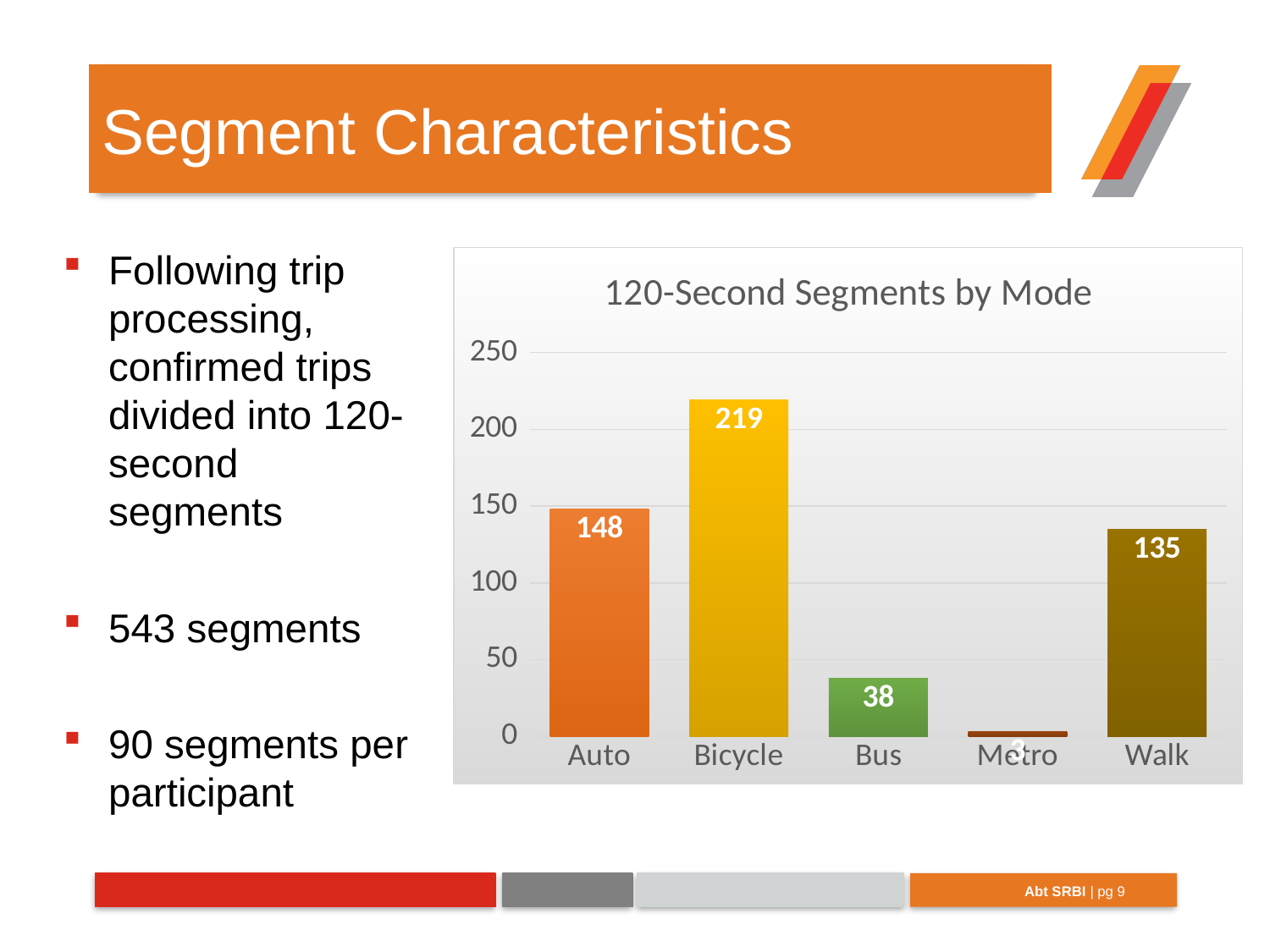
How many modes are shown on the x axis of the chart? 5 What is the value for Bus in the chart? 38 Which has a larger value, Auto or Walk? Auto Which mode has the lowest number of 120-second segments? Metro Which mode has the highest number of 120-second segments? Bicycle How many 120-second segments are shown for Bicycle? 219 What type of chart is shown on the slide? bar chart What is the value for Walk in the chart? 135 Is the value for Bus greater or less than 50? less What is the value for Auto in the chart? 148 What is the title of the chart? 120-Second Segments by Mode What is the difference between the values for Bicycle and Auto? 71